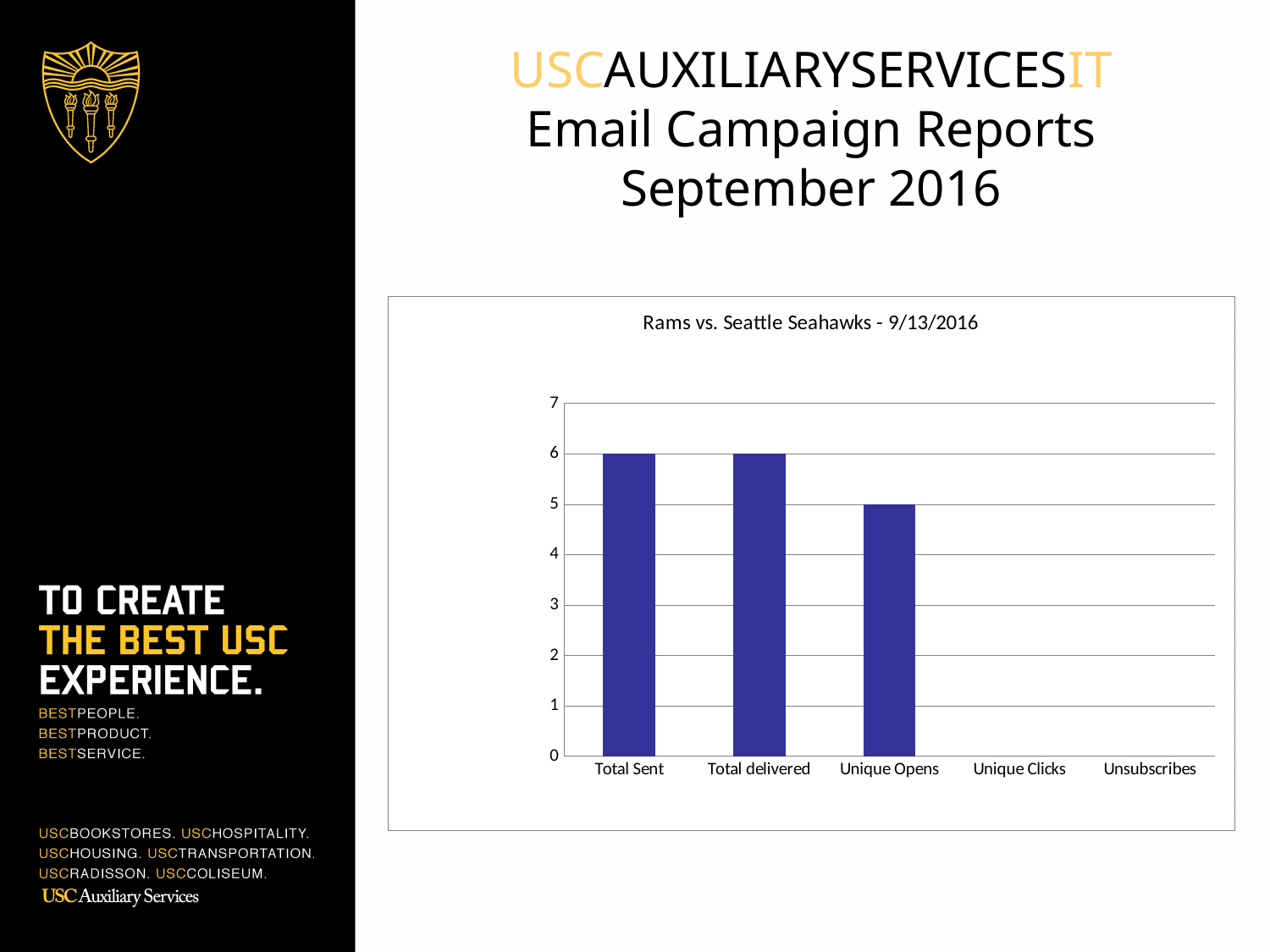
What is the difference between Total Sent and Unique Opens? 1 What is the value for Total delivered? 6 What is the highest value shown on the vertical axis? 7 What is the value for Total Sent? 6 What kind of chart is shown on the slide? bar chart What is the title of the chart? Rams vs. Seattle Seahawks - 9/13/2016 Which is larger, Total Sent or Unique Opens? Total Sent Is the value for Unique Opens greater or less than 4? greater What is the value for Unique Opens? 5 Do the values generally rise or fall from left to right across the categories? fall What is the value for Unique Clicks? 0 How many categories are shown on the x axis? 5